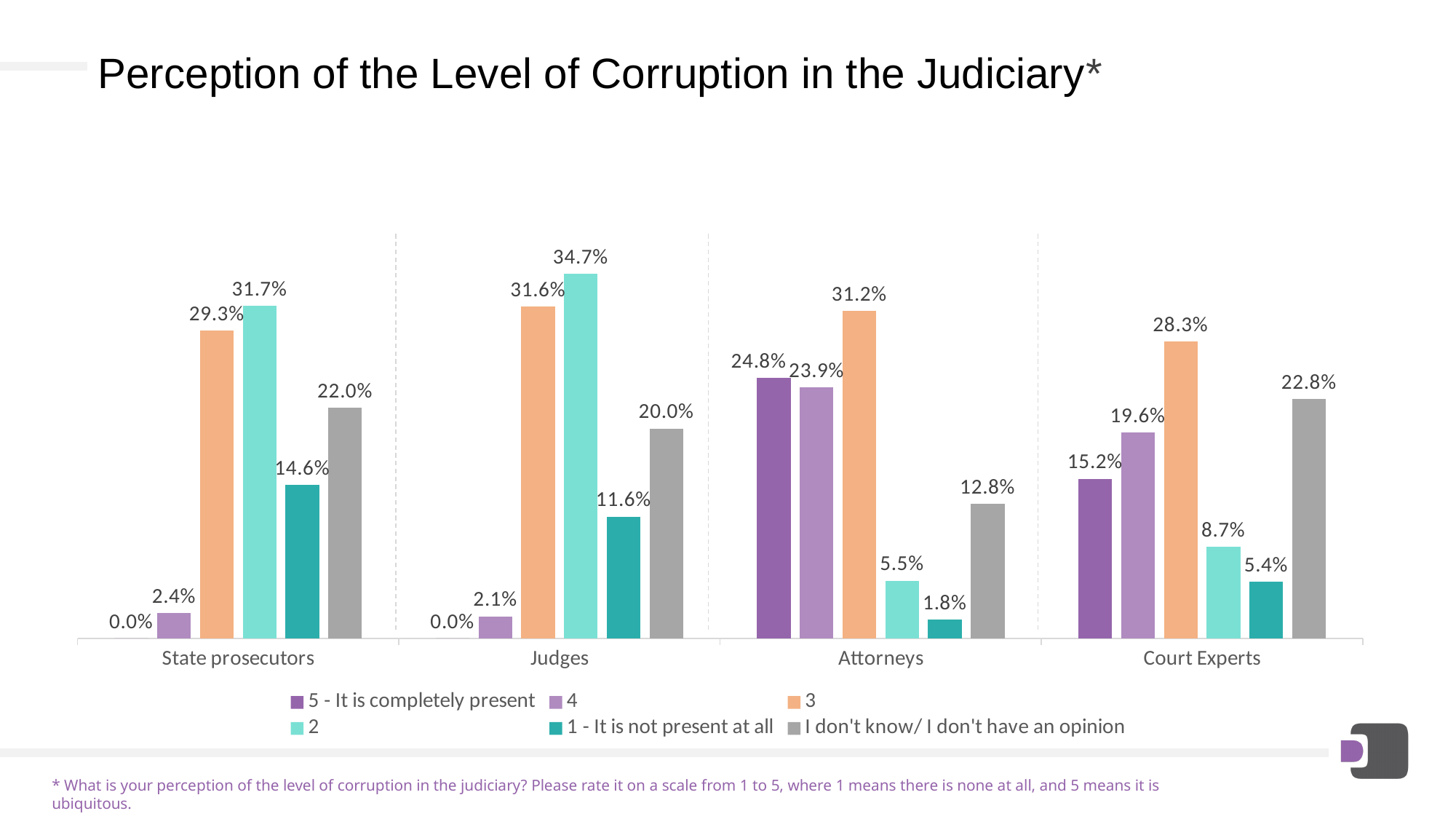
How many respondent groups are shown on the x axis? 4 What is the title of the chart? Perception of the Level of Corruption in the Judiciary* Which group has the highest share answering "3"? Judges What kind of chart is shown on the slide? Bar chart How many series does the legend list? 6 Which group has the lowest share answering "1 - It is not present at all"? Attorneys What is the difference between the share of Judges and the share of State prosecutors answering "2"? 3.0% What percentage of State prosecutors answered "1 - It is not present at all"? 14.6% What percentage of Court Experts answered "I don't know/ I don't have an opinion"? 22.8% What percentage of Judges answered "2"? 34.7% What percentage of Attorneys answered "5 - It is completely present"? 24.8% Which is larger: the share of Court Experts answering "4" or the share of Court Experts answering "5 - It is completely present"? 4